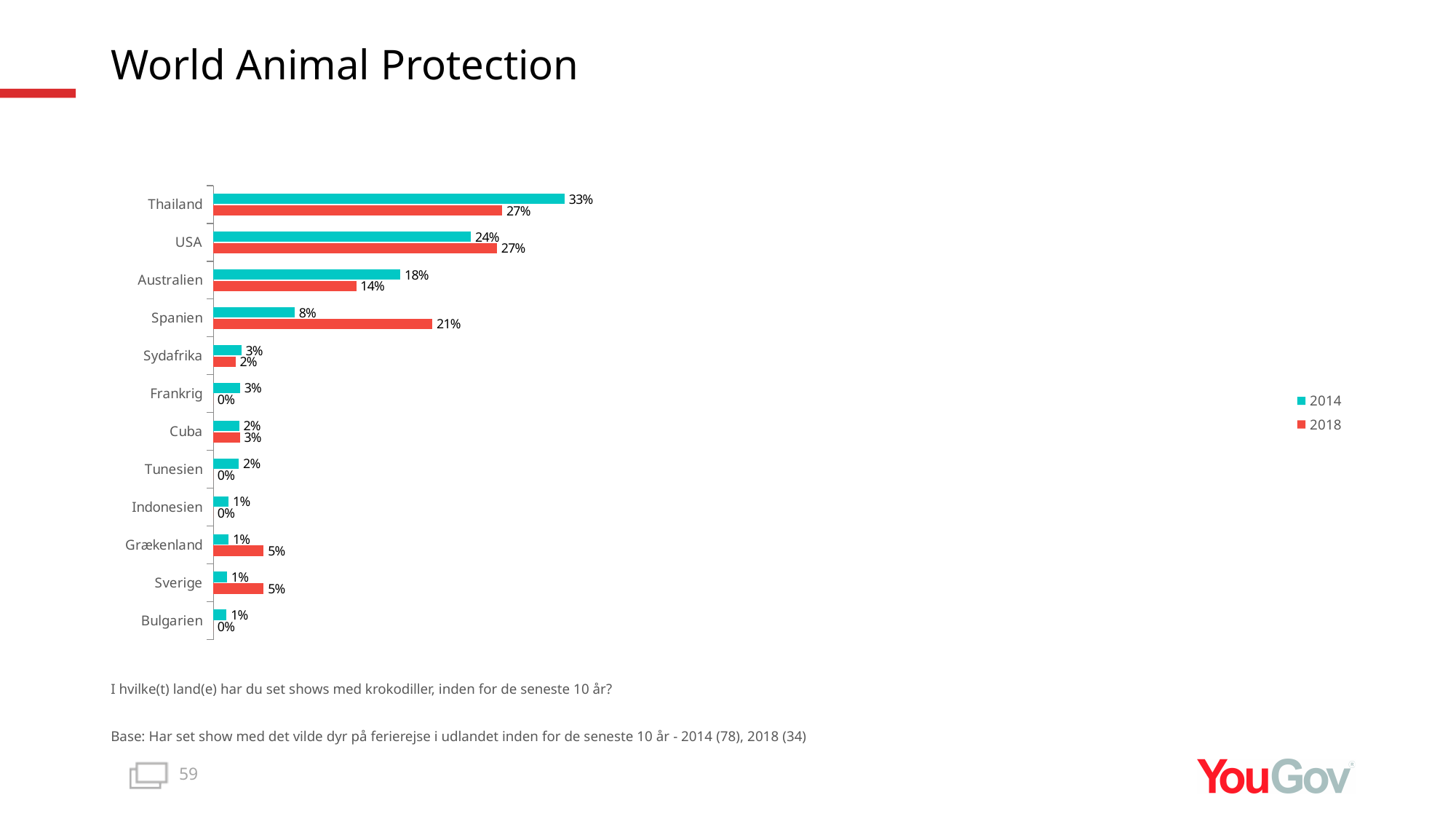
What is the 2018 value for Australien? 14% Which country has the highest 2018 value? USA and Thailand (both 27%) What is the 2014 value for Thailand? 33% What is the 2018 value for Spanien? 21% How many countries are shown on the chart? 12 What is the difference between the 2014 and 2018 values for Thailand? 6 percentage points What is the difference between the 2014 and 2018 values for Spanien? 13 percentage points Which colour represents the 2018 series in the legend? Red Which is larger for USA, the 2014 value or the 2018 value? 2018 How many series does the legend list? 2 What kind of chart is shown on the slide? Bar chart Which country has the highest 2014 value? Thailand